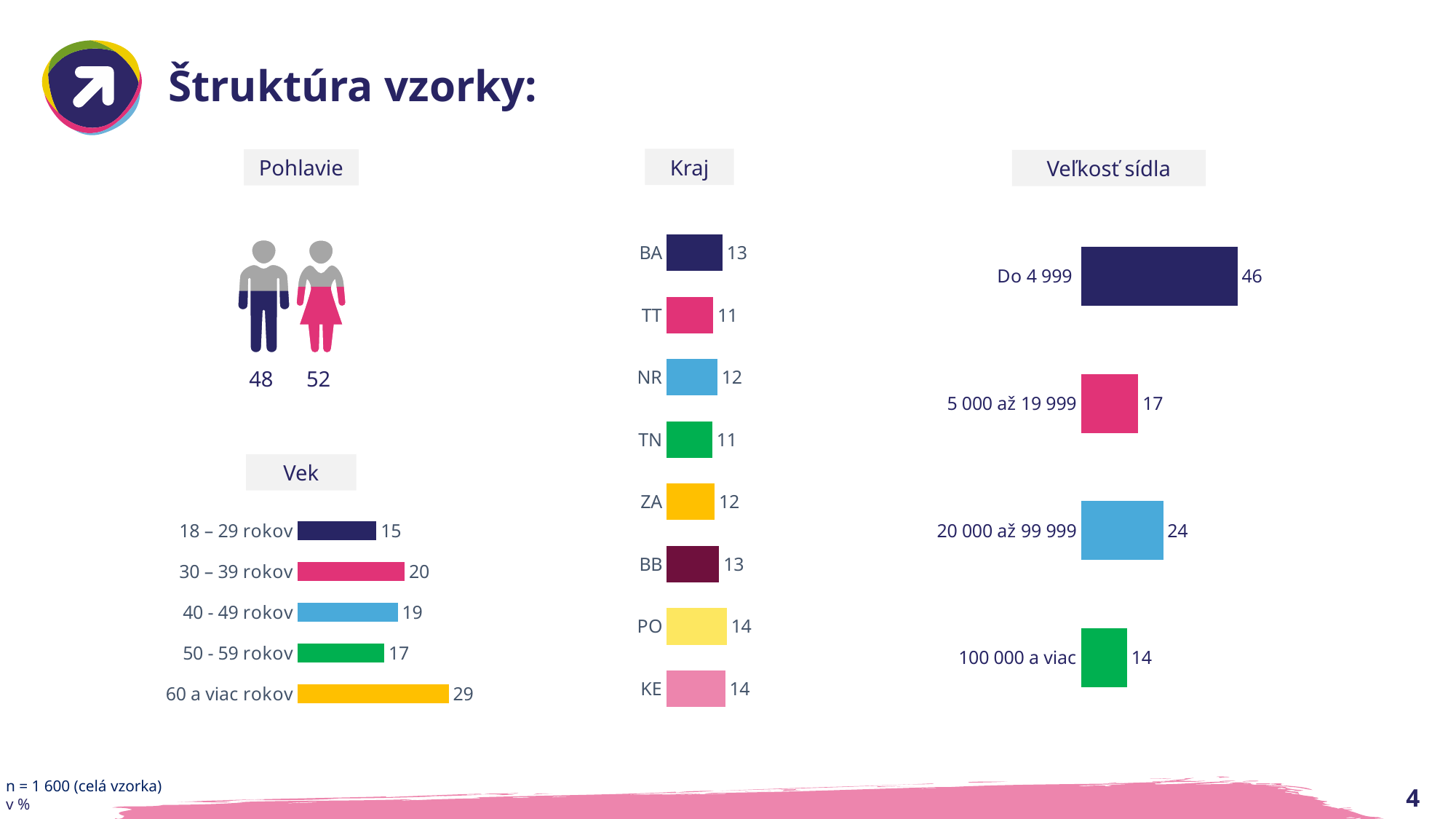
In the Veľkosť sídla chart, what is the value for 20 000 až 99 999? 24 In the Vek chart, what is the value for 60 a viac rokov? 29 In the Kraj chart, what is the difference between KE and TN? 3 In the Vek chart, how many age categories are shown? 5 In the Vek chart, which age group has the lowest value? 18 – 29 rokov In the Kraj chart, what is the value for PO? 14 In the Kraj chart, how many regions are listed? 8 In the Veľkosť sídla chart, which category has the highest value? Do 4 999 In the Kraj chart, which is larger, BA or TT? BA In the Veľkosť sídla chart, what is the difference between Do 4 999 and 100 000 a viac? 32 In the Vek chart, what is the difference between 30 – 39 rokov and 50 - 59 rokov? 3 What kind of chart is the Kraj chart? bar chart